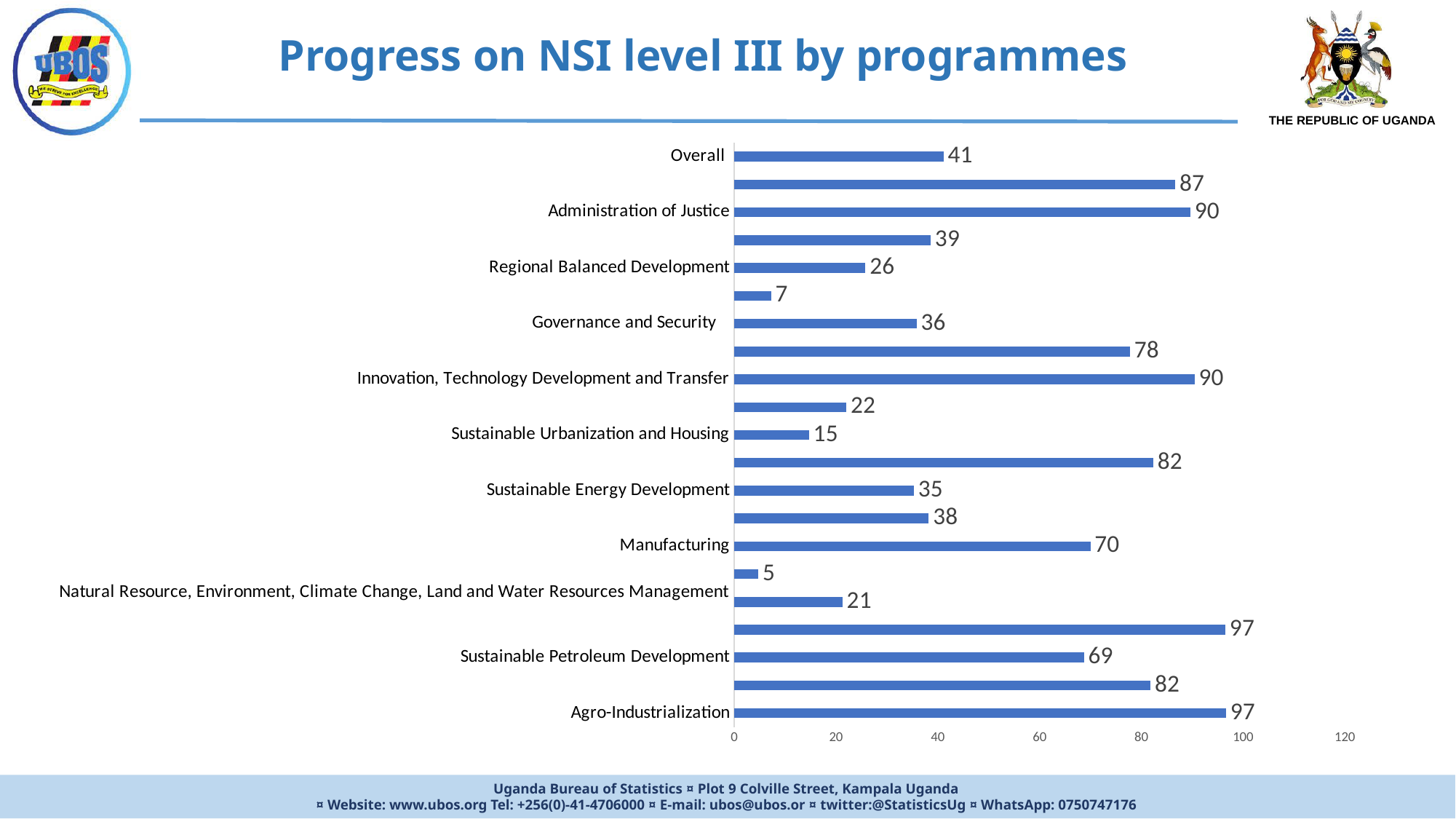
What is the value for Overall? 41 What is the title of the slide? Progress on NSI level III by programmes What is the value for Manufacturing? 70 What is the difference between the values for Agro-Industrialization and Manufacturing? 27 What is the value for Sustainable Urbanization and Housing? 15 What is the value for Regional Balanced Development? 26 Which has a larger value, Sustainable Petroleum Development or Sustainable Energy Development? Sustainable Petroleum Development What is the value for Administration of Justice? 90 What is the highest value labelled on any bar in the chart? 97 What is the value for Agro-Industrialization? 97 What kind of chart is shown on the slide? Bar chart How many bars are plotted in the chart? 21